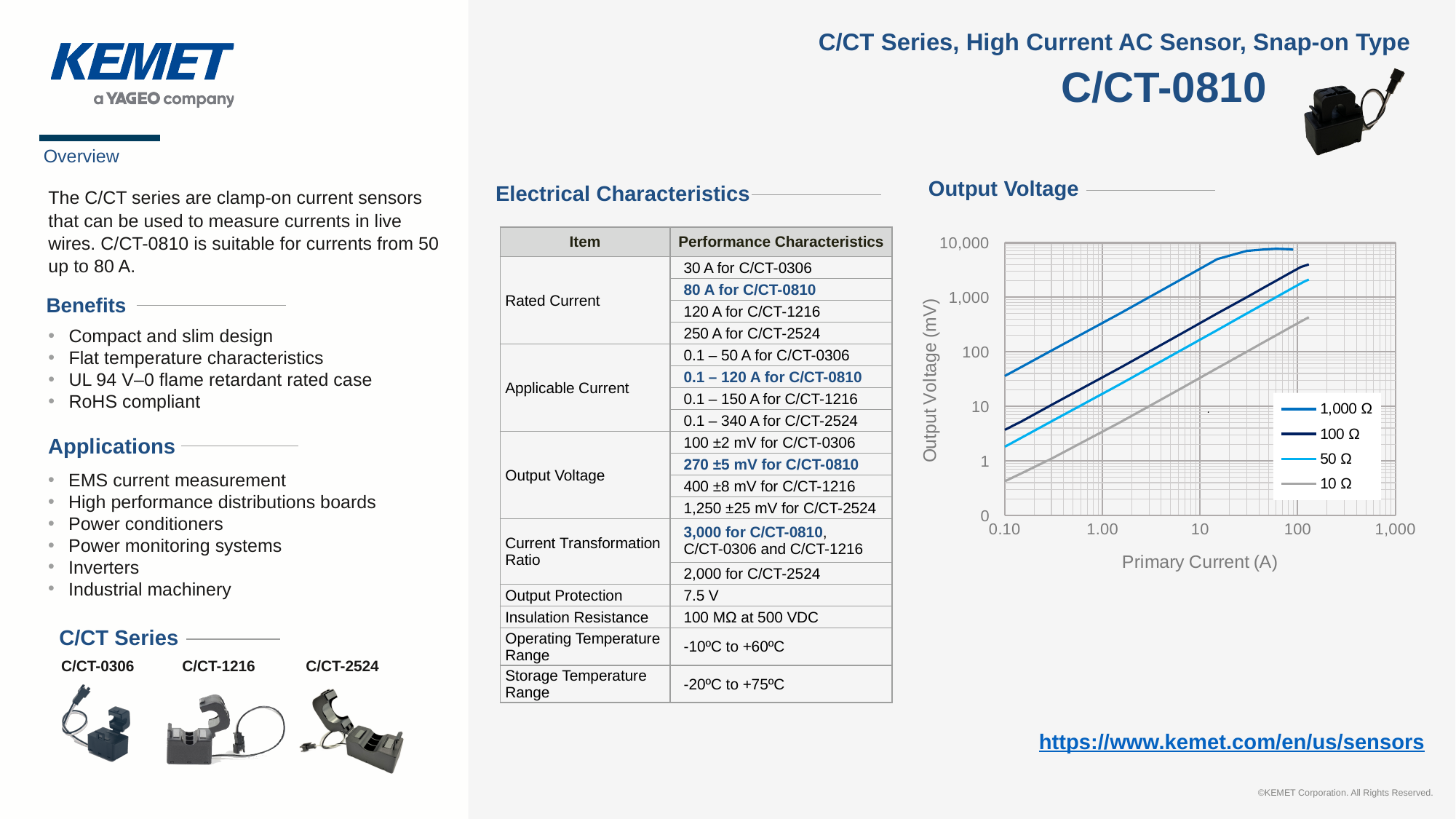
In the Output Voltage chart, is the output voltage of the 1,000 Ω series at 100 A greater or less than 1,000 mV? greater In the Output Voltage chart, which series has the highest output voltage across the plotted current range? 1,000 Ω What kind of chart is the Output Voltage chart? line chart In the Output Voltage chart, is the output voltage of the 100 Ω series at 10 A greater or less than 100 mV? greater What is the x-axis title of the Output Voltage chart? Primary Current (A) In the Output Voltage chart, which series has the lowest output voltage across the plotted current range? 10 Ω In the Output Voltage chart, is the output voltage of the 10 Ω series at 1.00 A greater or less than 10 mV? less What is the y-axis title of the Output Voltage chart? Output Voltage (mV) In the Output Voltage chart, at 10 A, which series has the larger output voltage: 50 Ω or 100 Ω? 100 Ω How many series does the legend of the Output Voltage chart list? 4 In the Output Voltage chart, does the output voltage rise or fall as primary current increases? rises